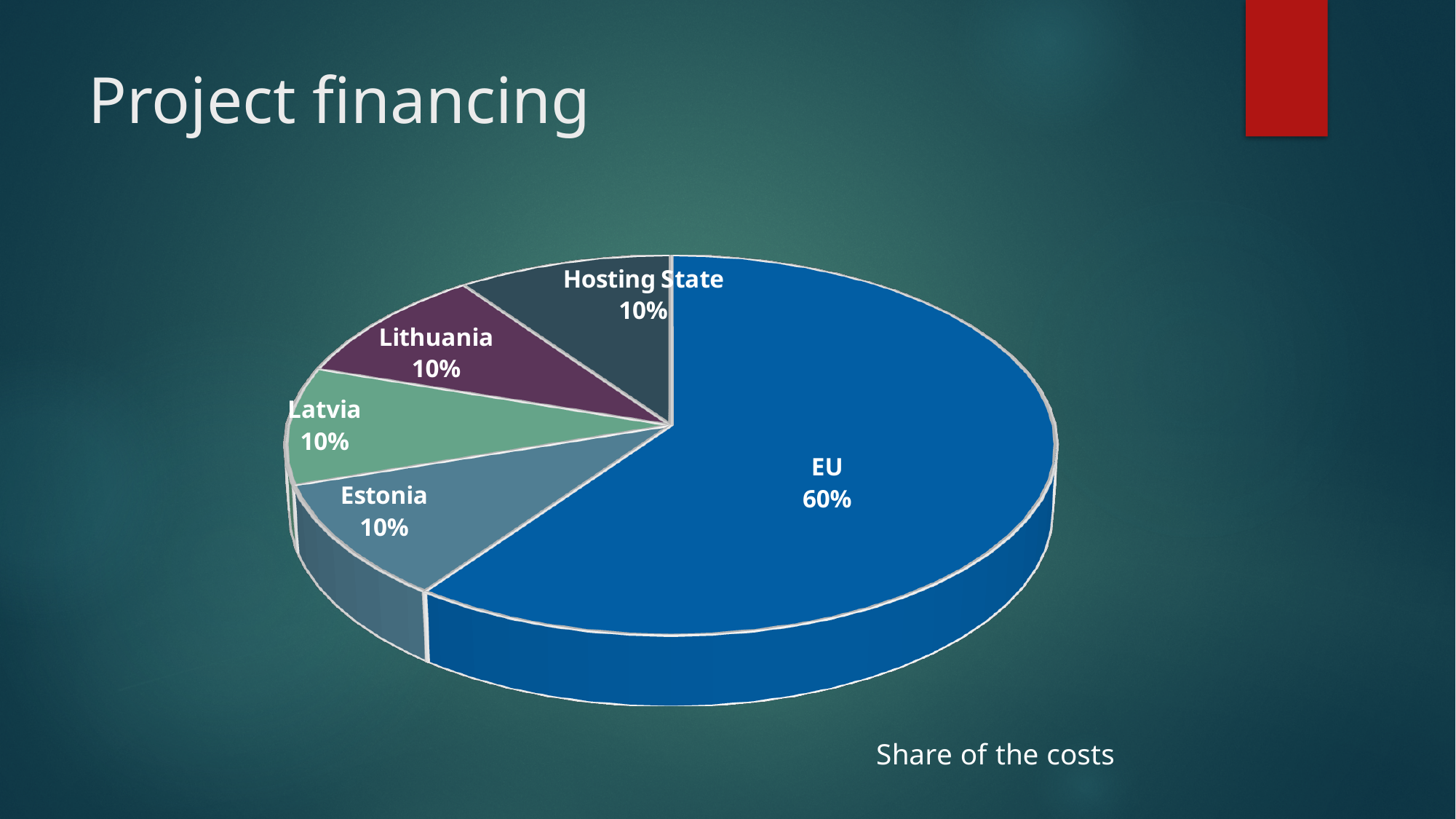
What is the title of the slide containing the chart? Project financing What share of the costs does Estonia cover? 10% Which contributor has the largest share of the costs? EU What is the difference between the EU's share and Latvia's share? 50% How many slices does the pie chart have? 5 What caption appears below the pie chart? Share of the costs What share of the costs does the Hosting State cover? 10% What kind of chart is shown on the slide? Pie chart What is the combined share of Estonia, Latvia and Lithuania? 30% Which is larger, the EU's share or Estonia's share? EU What share of the costs does the EU cover? 60% What share of the costs does Lithuania cover? 10%